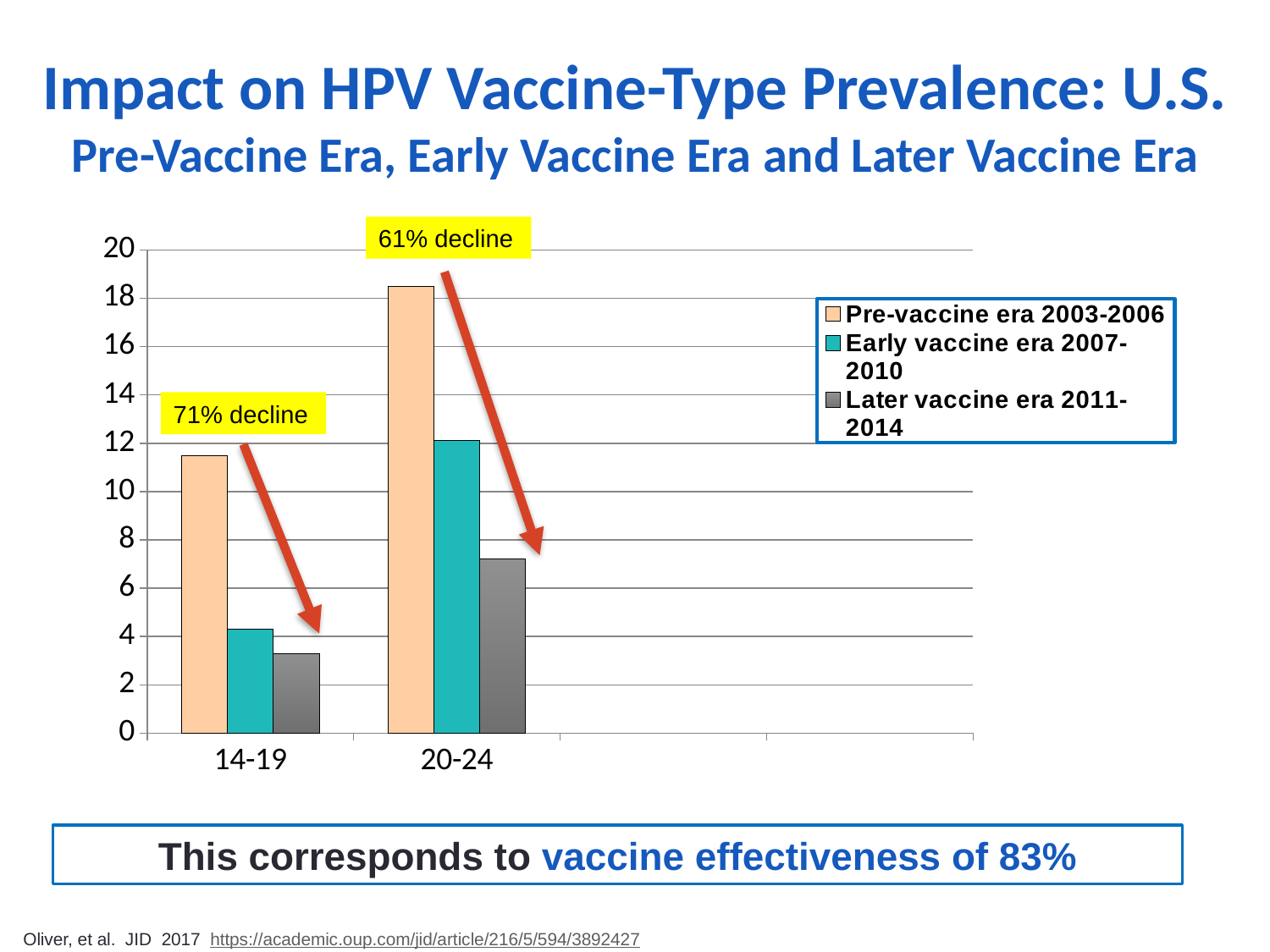
Is the Early vaccine era 2007-2010 value for the 20-24 age group greater or less than 10? greater How many age-group categories are shown on the x axis? 2 Is the Later vaccine era 2011-2014 value for the 14-19 age group greater or less than 4? less What percentage decline is annotated for the 20-24 age group? 61% decline Which series has the lowest value for the 14-19 age group? Later vaccine era 2011-2014 Is the Pre-vaccine era 2003-2006 value for the 14-19 age group greater or less than 10? greater What percentage decline is annotated for the 14-19 age group? 71% decline Which is larger: the Early vaccine era 2007-2010 value for 14-19 or the Later vaccine era 2011-2014 value for 20-24? Later vaccine era 2011-2014 value for 20-24 Which age group has the highest Pre-vaccine era 2003-2006 value? 20-24 What kind of chart is shown on the slide? bar chart How many series does the legend list? 3